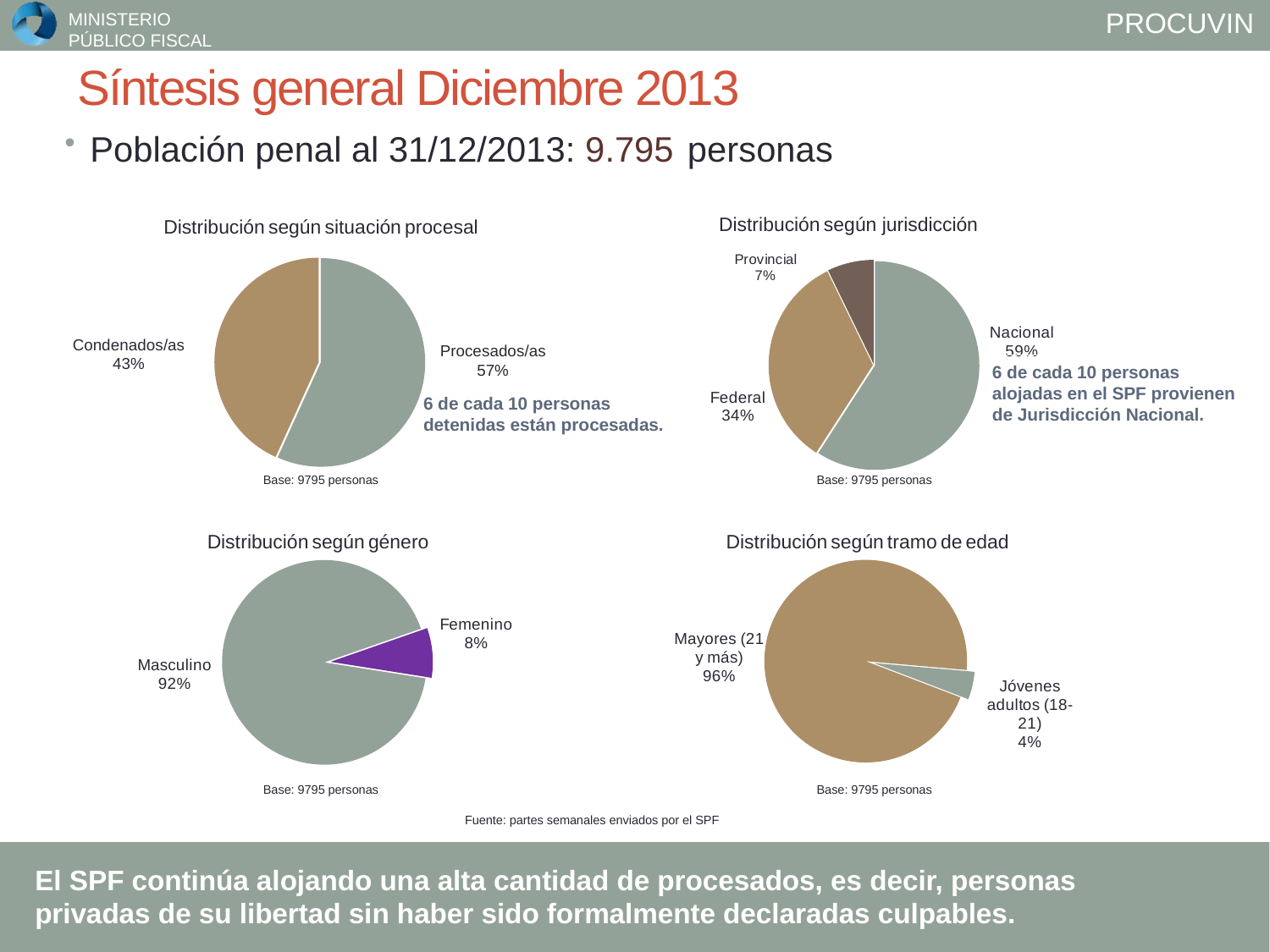
In the 'Distribución según situación procesal' chart, what share is Condenados/as? 43% In the 'Distribución según situación procesal' chart, what share is Procesados/as? 57% What type of chart is 'Distribución según situación procesal'? Pie chart In the 'Distribución según jurisdicción' chart, which category has the smallest share? Provincial In the 'Distribución según género' chart, what share is Femenino? 8% In the 'Distribución según tramo de edad' chart, what share is Mayores (21 y más)? 96% In the 'Distribución según jurisdicción' chart, what share is Federal? 34% In the 'Distribución según género' chart, which is larger, Masculino or Femenino? Masculino In the 'Distribución según tramo de edad' chart, what share is Jóvenes adultos (18-21)? 4% In the 'Distribución según jurisdicción' chart, which category has the largest share? Nacional In the 'Distribución según jurisdicción' chart, how many categories are shown? 3 In the 'Distribución según jurisdicción' chart, what is the difference between the Nacional and Federal shares? 25%